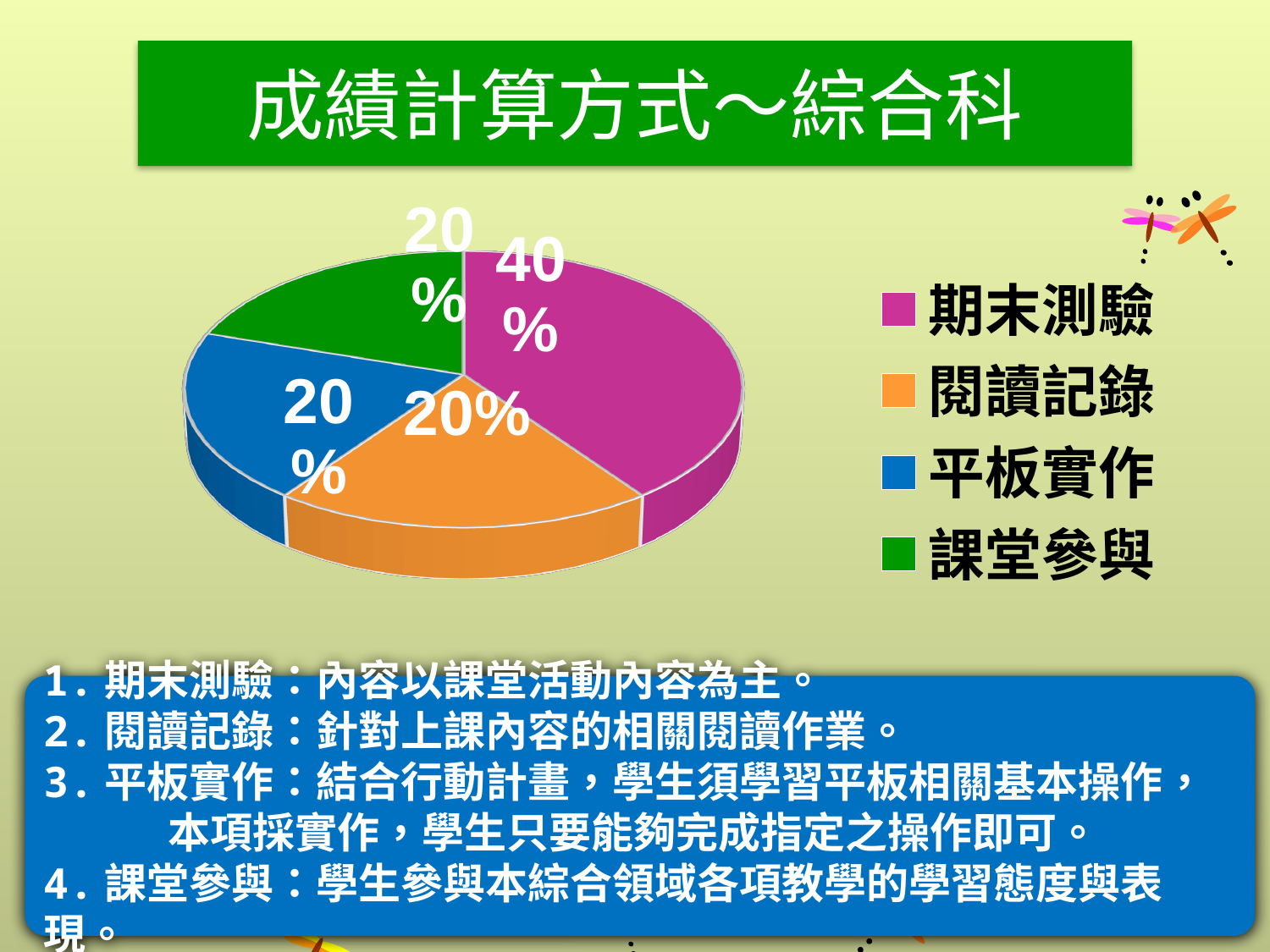
What percentage does the 期末測驗 slice show? 40% Which category has the largest slice of the pie? 期末測驗 What is the difference between the 期末測驗 share and the 閱讀記錄 share? 20% What percentage does the 平板實作 slice show? 20% What kind of chart is shown on the slide? Pie chart Which is larger, the 期末測驗 slice or the 平板實作 slice? 期末測驗 How many slices does the pie chart have? 4 How many entries does the legend list? 4 What share of the pie does 期末測驗 take? 40% What colour is the 課堂參與 slice? Green What percentage does the 課堂參與 slice show? 20% What percentage does the 閱讀記錄 slice show? 20%